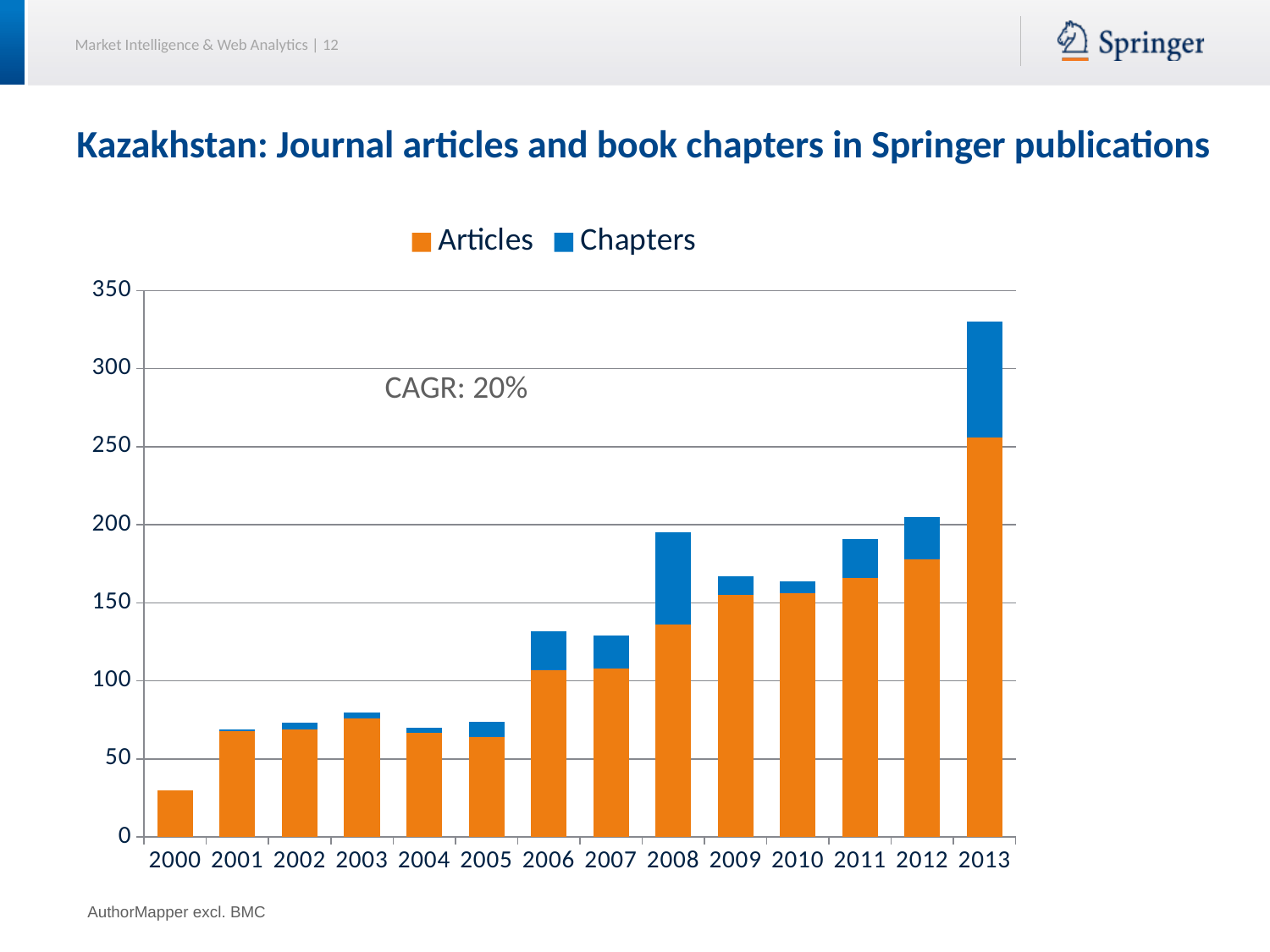
Is the total value for 2008 greater or less than 150? greater What kind of chart is shown on the slide? Stacked bar chart Which year has the lowest total bar in the chart? 2000 Do the total values generally rise or fall from 2000 to 2013? rise Which year has the highest total bar in the chart? 2013 Which year has the larger total bar, 2007 or 2008? 2008 What CAGR is stated on the chart? 20% Is the Articles value for 2006 greater or less than 100? greater How many years are shown on the x axis of the chart? 14 Is the value for 2000 greater or less than 50? less How many series does the chart's legend list? 2